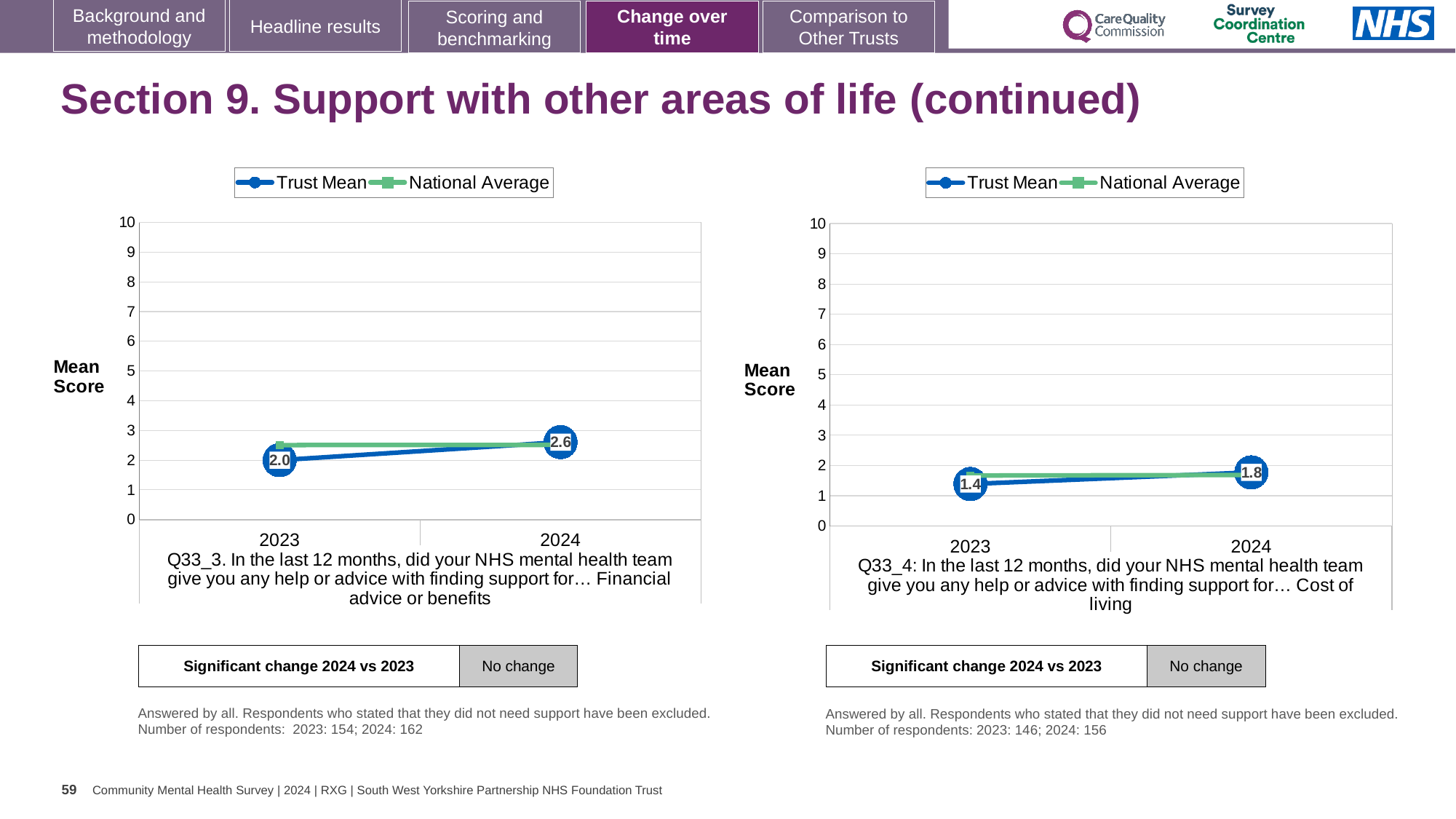
How many series does the legend of the left chart list? 2 In the right chart (Q33_4, Cost of living), what is the Trust Mean for 2023? 1.4 In the left chart (Q33_3, Financial advice or benefits), what is the Trust Mean for 2023? 2.0 In the left chart (Q33_3, Financial advice or benefits), what is the Trust Mean for 2024? 2.6 In the right chart (Q33_4), is the National Average for 2023 greater or less than 2? less In the right chart (Q33_4), which year has the higher Trust Mean, 2023 or 2024? 2024 In the left chart (Q33_3), does the Trust Mean rise or fall from 2023 to 2024? rise In the left chart (Q33_3), by how much did the Trust Mean change from 2023 to 2024? 0.6 In the left chart (Q33_3), is the National Average for 2023 greater or less than 2? greater What type of chart is used in the right chart (Q33_4)? line chart In the right chart (Q33_4, Cost of living), what is the Trust Mean for 2024? 1.8 In the right chart (Q33_4), what is the difference between the Trust Mean for 2024 and 2023? 0.4